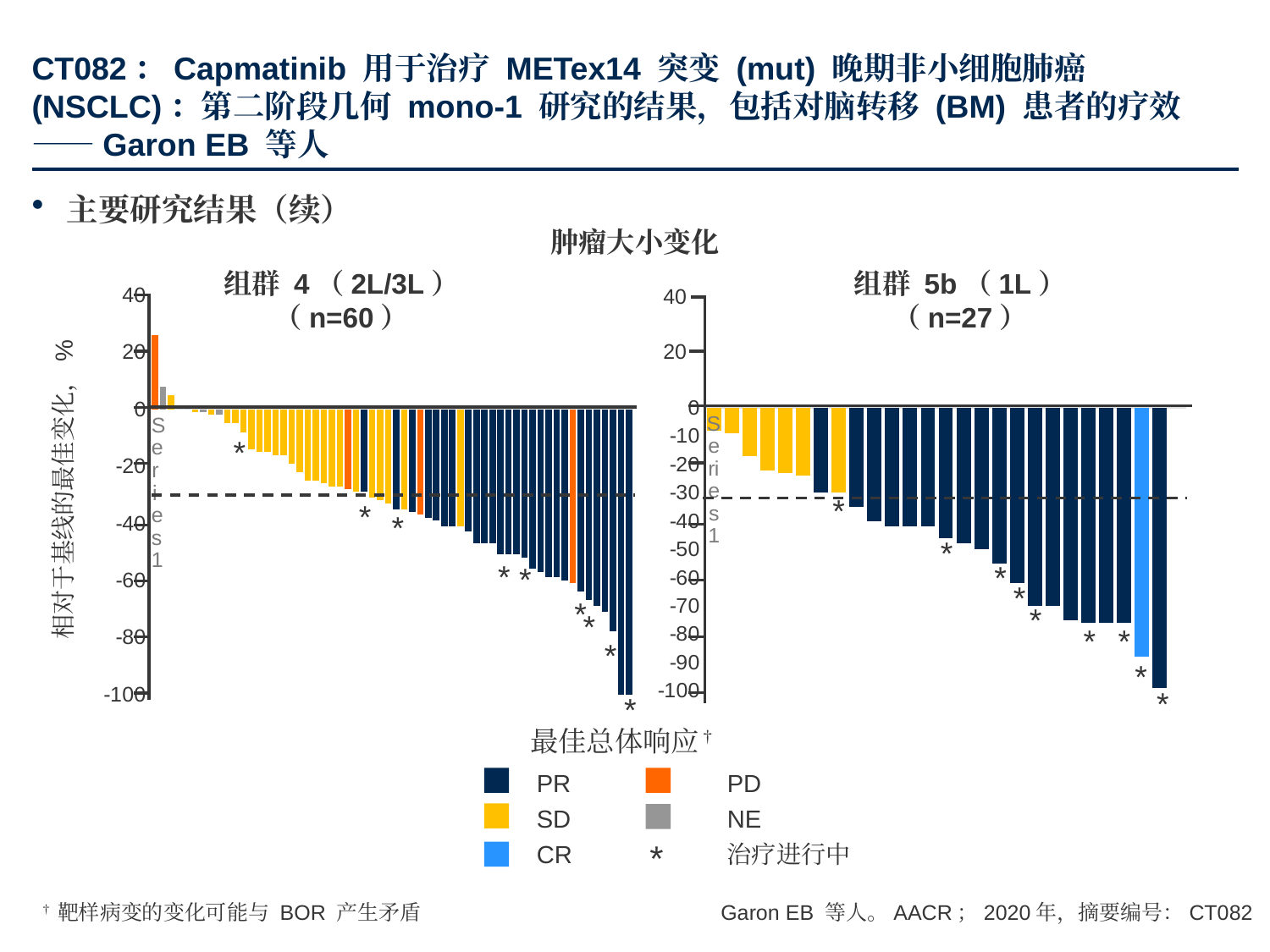
What does the asterisk (*) symbol in the legend indicate? 治疗进行中 In the 组群 4 (2L/3L) chart, is the value of the lowest bar greater or less than -80? less In the 组群 5b (1L) chart, do the bar values rise or fall from left to right along the x axis? fall In the 组群 4 (2L/3L) chart, is the value of the tallest positive (orange) bar greater or less than 20? greater In the 组群 5b (1L) chart, is the value of the light blue (CR) bar greater or less than -80? less According to its title, how many patients (n) are included in the 组群 4 (2L/3L) chart? 60 Which colour represents PD (progressive disease) in the legend? orange What kind of chart is used to show the tumor size change for 组群 4 (2L/3L)? bar chart How many best overall response categories (colour entries) does the legend list? 5 How many charts are shown on the slide under the heading 肿瘤大小变化? 2 According to its title, how many patients (n) are included in the 组群 5b (1L) chart? 27